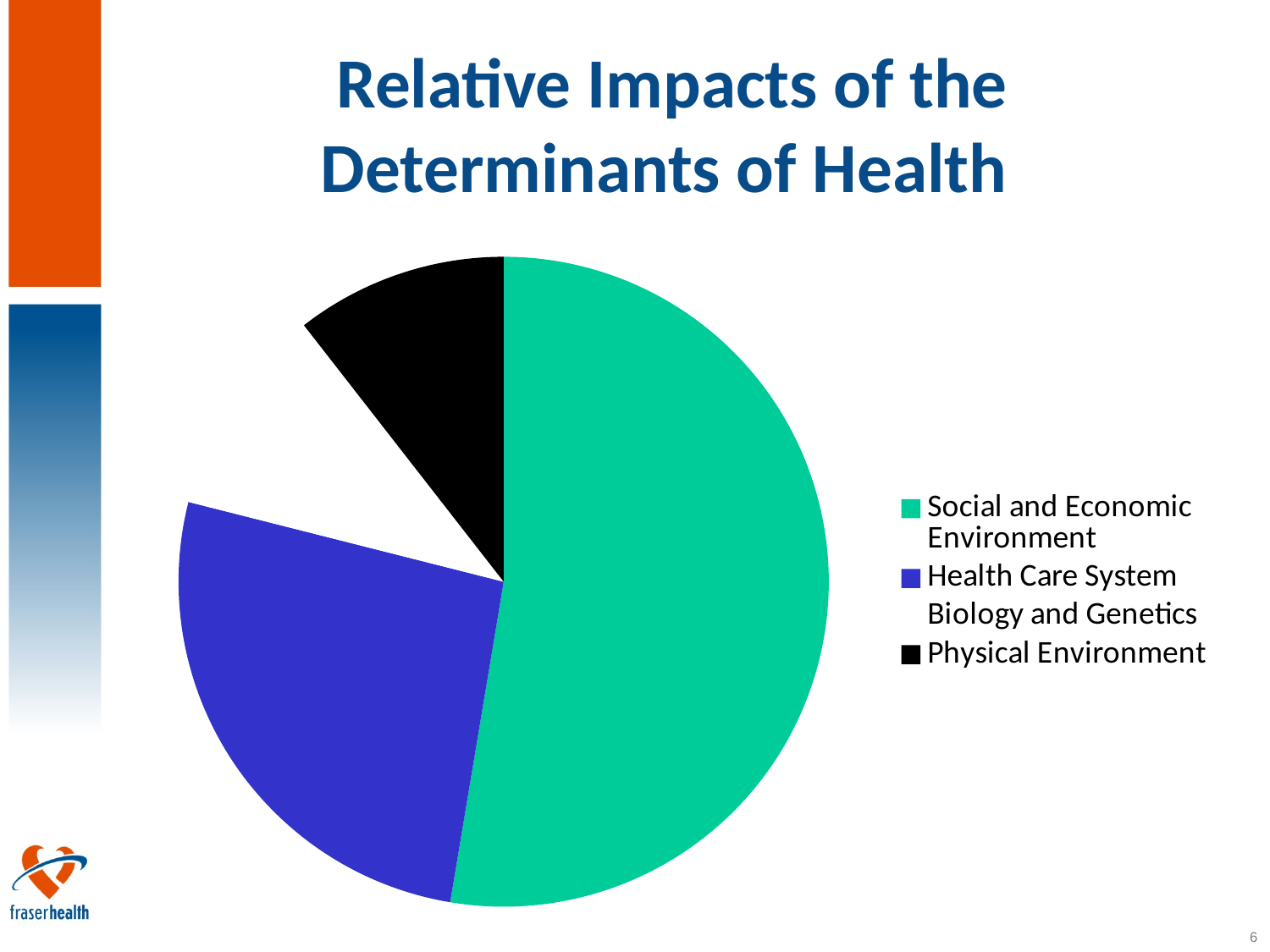
Does the Social and Economic Environment slice take up more or less than a quarter of the pie? More Which slice is larger, Health Care System or Physical Environment? Health Care System How many slices does the pie chart have? 4 Which category has the largest slice of the pie chart? Social and Economic Environment Which slice is larger, Social and Economic Environment or Physical Environment? Social and Economic Environment What colour is the Health Care System slice in the pie chart? Blue What kind of chart is shown on the slide? Pie chart What is the title of the chart on the slide? Relative Impacts of the Determinants of Health How many categories does the legend of the pie chart list? 4